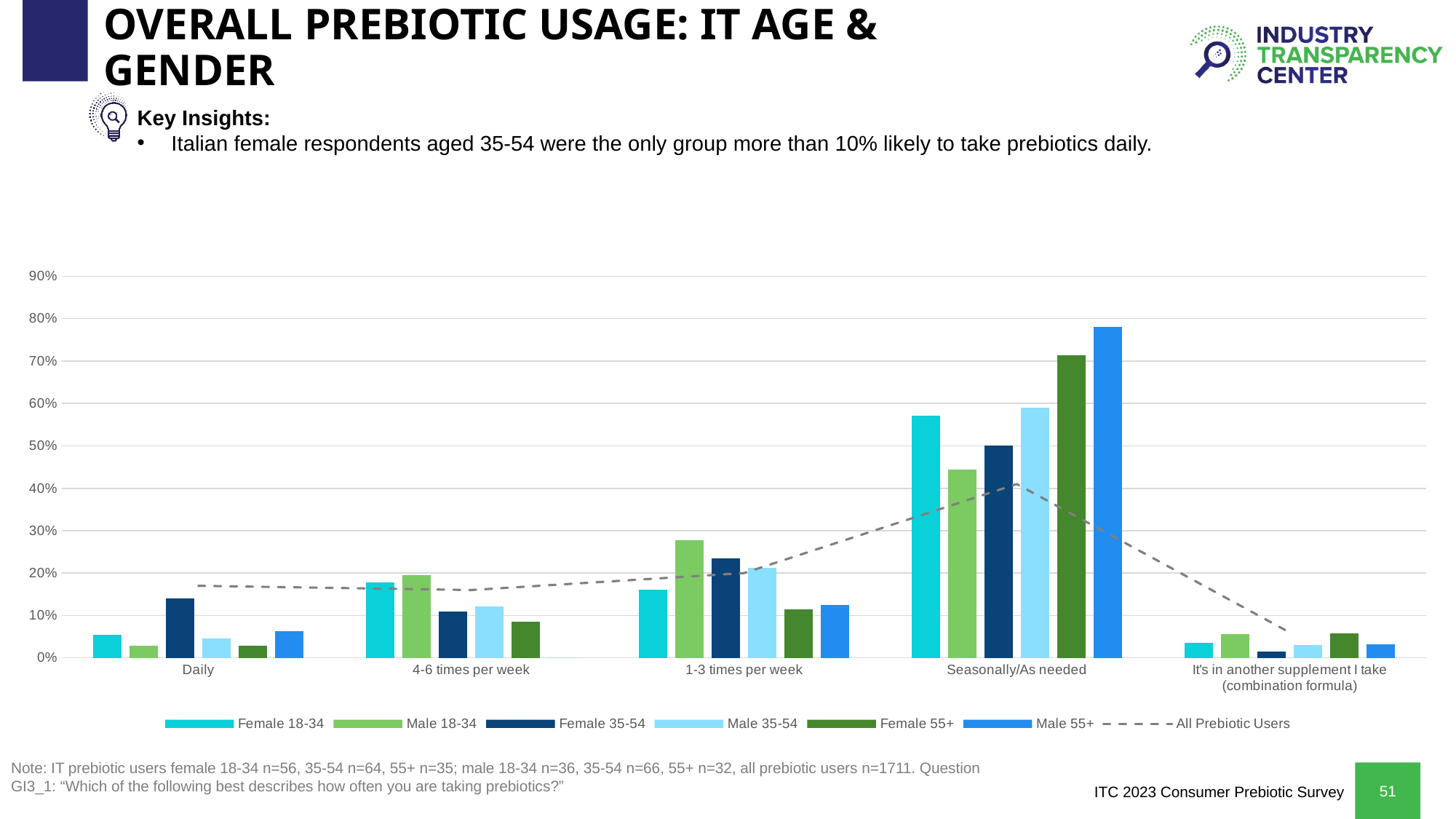
How many series does the legend list? 7 What does the dashed grey line in the chart represent? All Prebiotic Users How many frequency categories are shown along the x axis? 5 Is the value for Female 55+ in the Seasonally/As needed category greater or less than 60%? greater In the 1-3 times per week category, which is larger: Male 18-34 or Female 18-34? Male 18-34 What kind of chart is shown on the slide? combination bar and line chart Is the value for Male 55+ in the Seasonally/As needed category greater or less than 70%? greater Which group has the lowest bar in the Seasonally/As needed category? Male 18-34 Is the value for Male 18-34 in the 1-3 times per week category greater or less than 20%? greater Which group has the highest bar in the Daily category? Female 35-54 Which group has the highest bar in the Seasonally/As needed category? Male 55+